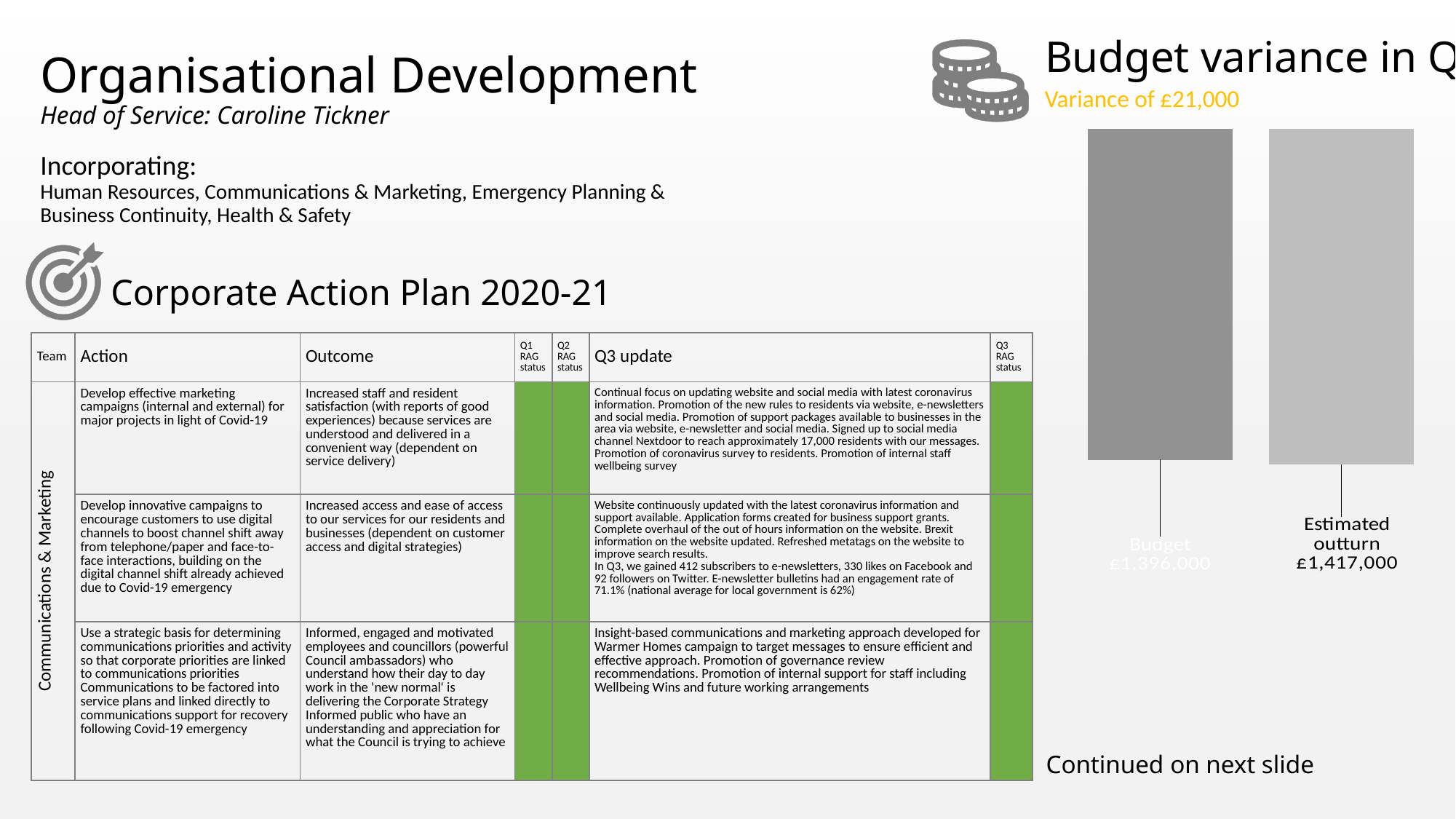
What variance amount is stated above the budget variance chart? Variance of £21,000 What is the value of the Budget bar in the budget variance chart? £1,396,000 In the budget variance chart, which bar is taller: Budget or Estimated outturn? Estimated outturn How many bars are shown in the budget variance chart? 2 Is the Estimated outturn in the budget variance chart greater or less than the Budget? greater Which category has the lowest value in the budget variance chart? Budget What is the difference between the Estimated outturn and the Budget in the budget variance chart? £21,000 What is the value of the Estimated outturn bar in the budget variance chart? £1,417,000 Which category has the highest value in the budget variance chart? Estimated outturn What type of chart is used to show the budget variance? Bar chart